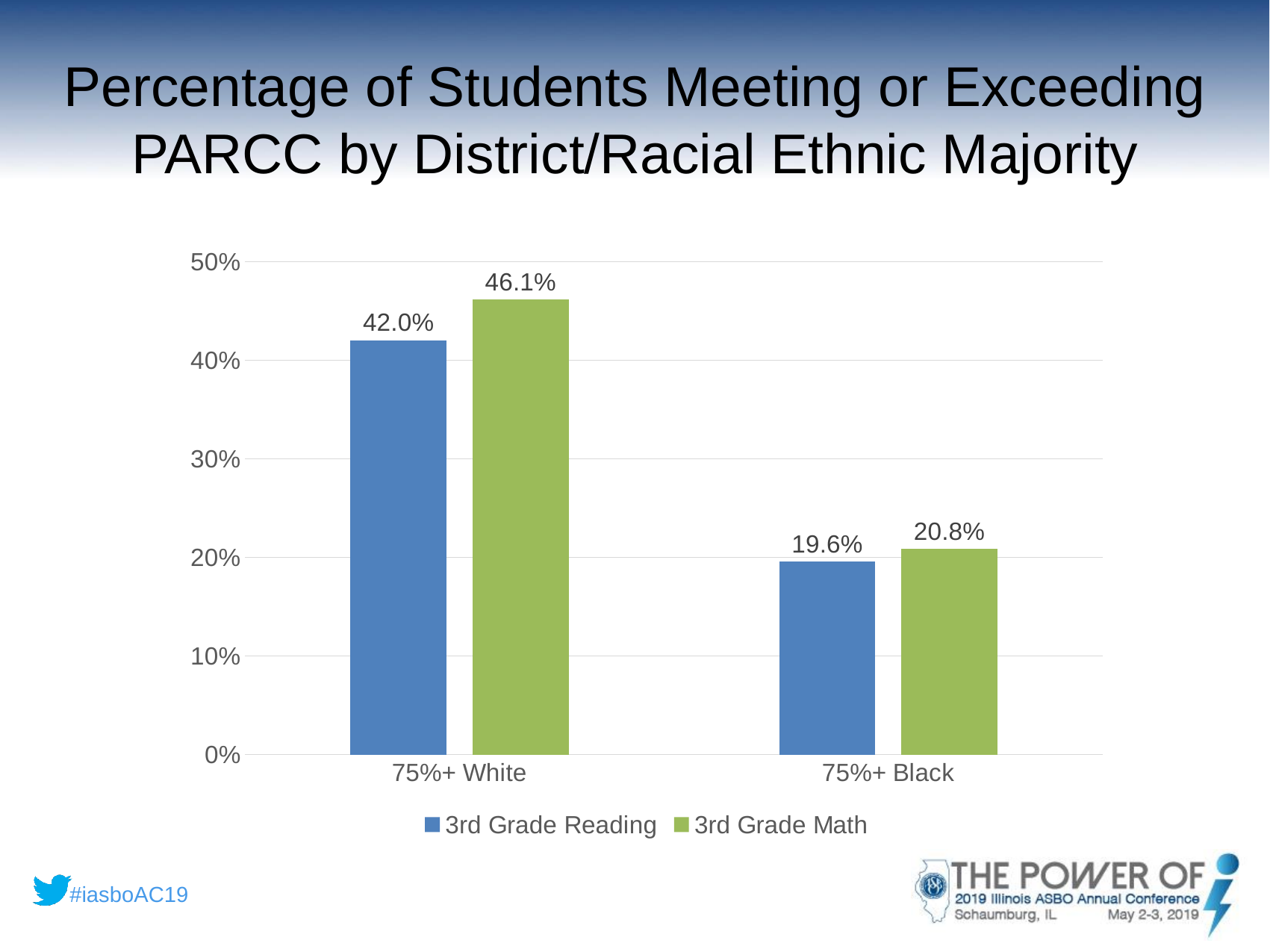
What is the 3rd Grade Reading value for 75%+ Black districts? 19.6% How many series does the legend list? 2 How many categories are shown on the x axis? 2 What kind of chart is shown on the slide? Bar chart What is the difference between 3rd Grade Math and 3rd Grade Reading for 75%+ White districts? 4.1% Which is larger for 75%+ Black districts, 3rd Grade Reading or 3rd Grade Math? 3rd Grade Math What is the 3rd Grade Math value for 75%+ White districts? 46.1% Which bar has the highest value on the chart? 3rd Grade Math for 75%+ White What is the 3rd Grade Reading value for 75%+ White districts? 42.0% What is the difference between the 3rd Grade Math values for 75%+ White and 75%+ Black districts? 25.3% Which bar has the lowest value on the chart? 3rd Grade Reading for 75%+ Black What is the 3rd Grade Math value for 75%+ Black districts? 20.8%